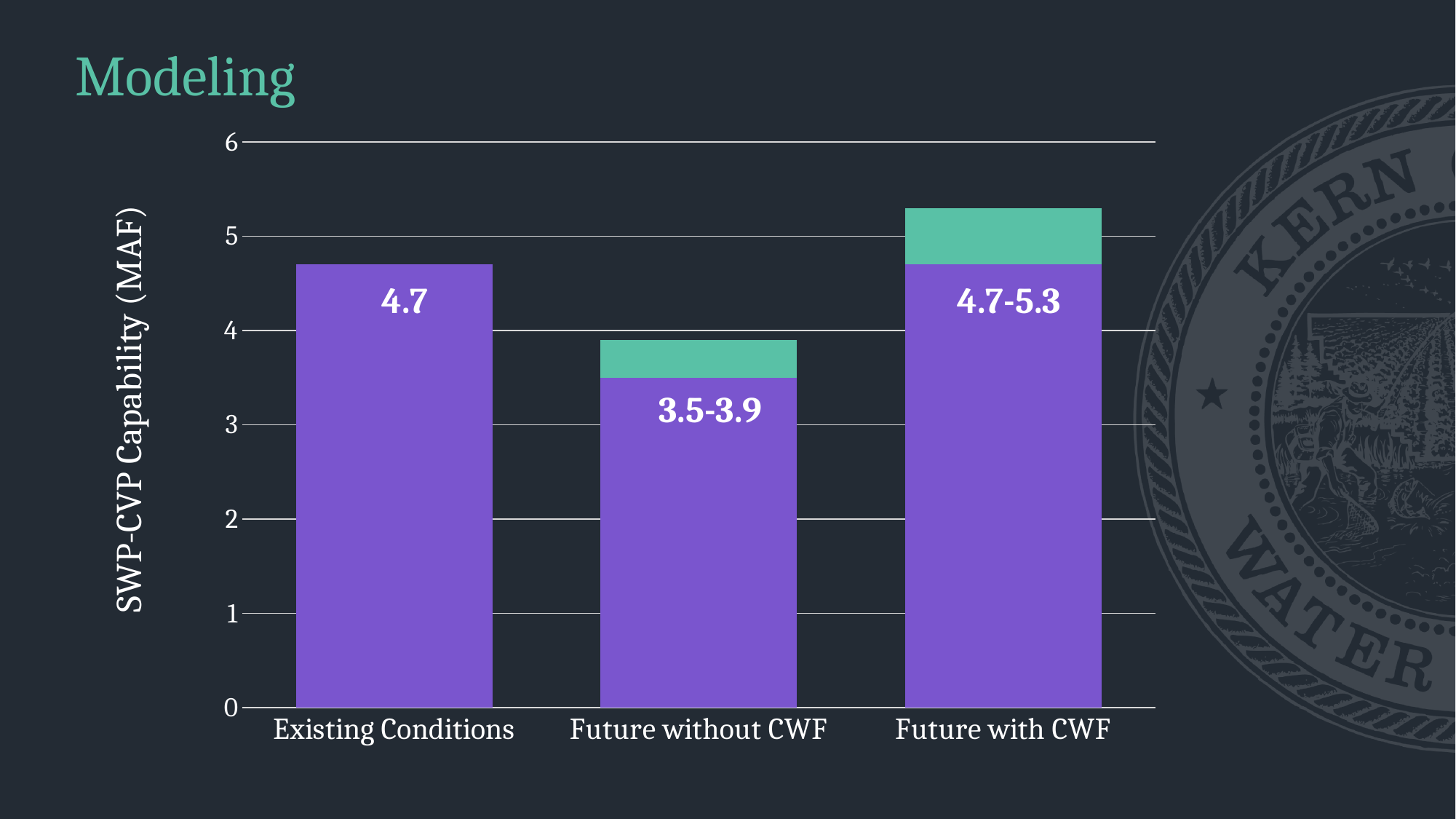
What is the labeled value range for Future with CWF? 4.7-5.3 Is the top of the bar for Future without CWF greater or less than 4? less What is the labeled value for Existing Conditions? 4.7 What is the labeled value range for Future without CWF? 3.5-3.9 How many categories are shown on the x axis? 3 Which is larger, the value for Existing Conditions or the value for Future without CWF? Existing Conditions Is the value for Existing Conditions greater or less than 4? greater What kind of chart is shown on the slide? bar chart What is the title of the slide? Modeling Which category has the highest SWP-CVP capability? Future with CWF Which category has the lowest SWP-CVP capability? Future without CWF What is the label of the y axis? SWP-CVP Capability (MAF)